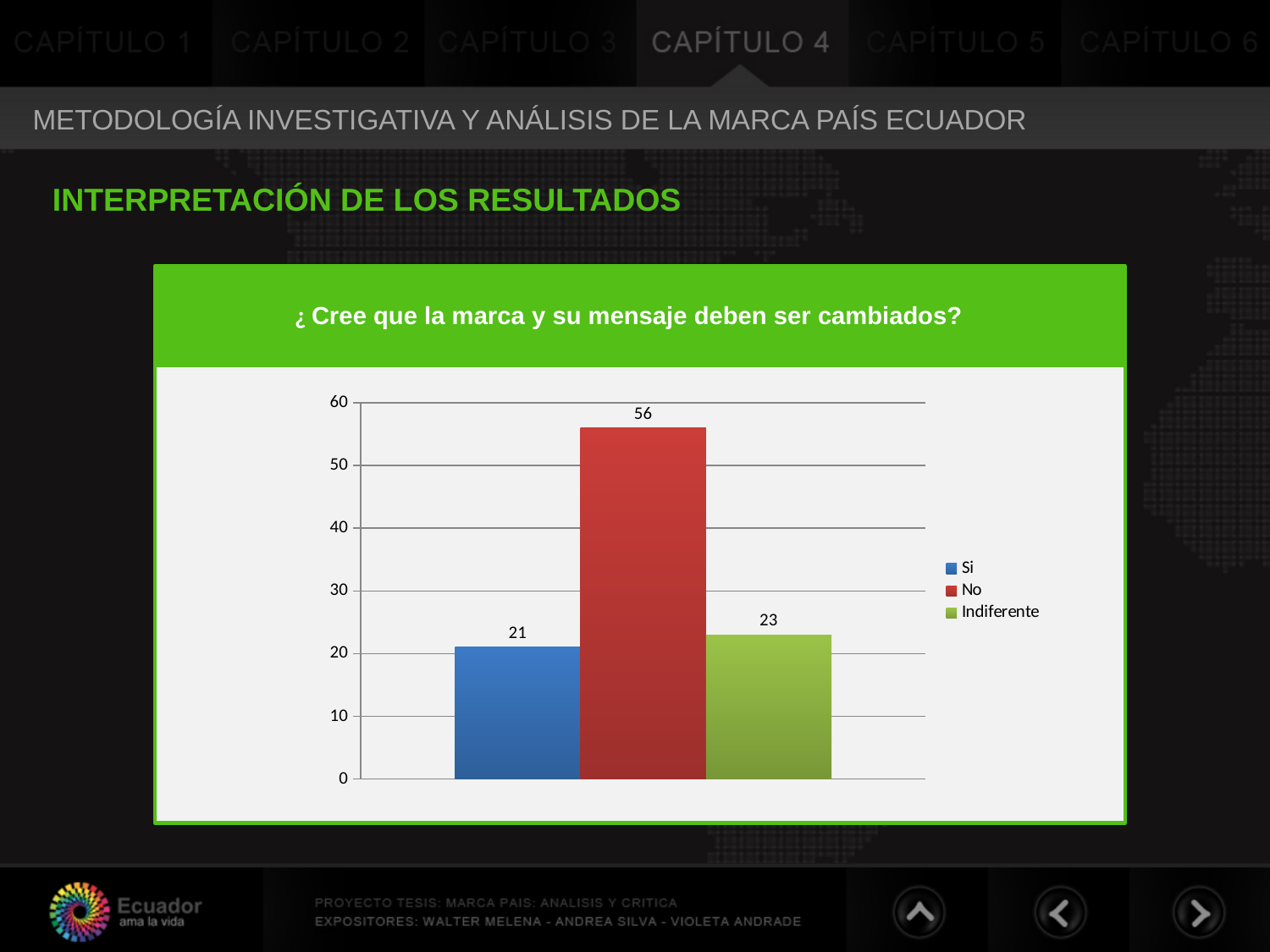
Which is larger, the value for "No" or the value for "Indiferente"? No What is the difference between the values for "Indiferente" and "Si"? 2 What is the title of the chart? ¿ Cree que la marca y su mensaje deben ser cambiados? Which category has the highest value? No What is the difference between the values for "No" and "Si"? 35 How many entries does the legend list? 3 What is the value for "Indiferente"? 23 What kind of chart is shown on the slide? bar chart What is the value for "Si"? 21 Which category has the lowest value? Si What is the value for "No"? 56 Is the value for "No" greater or less than 50? greater